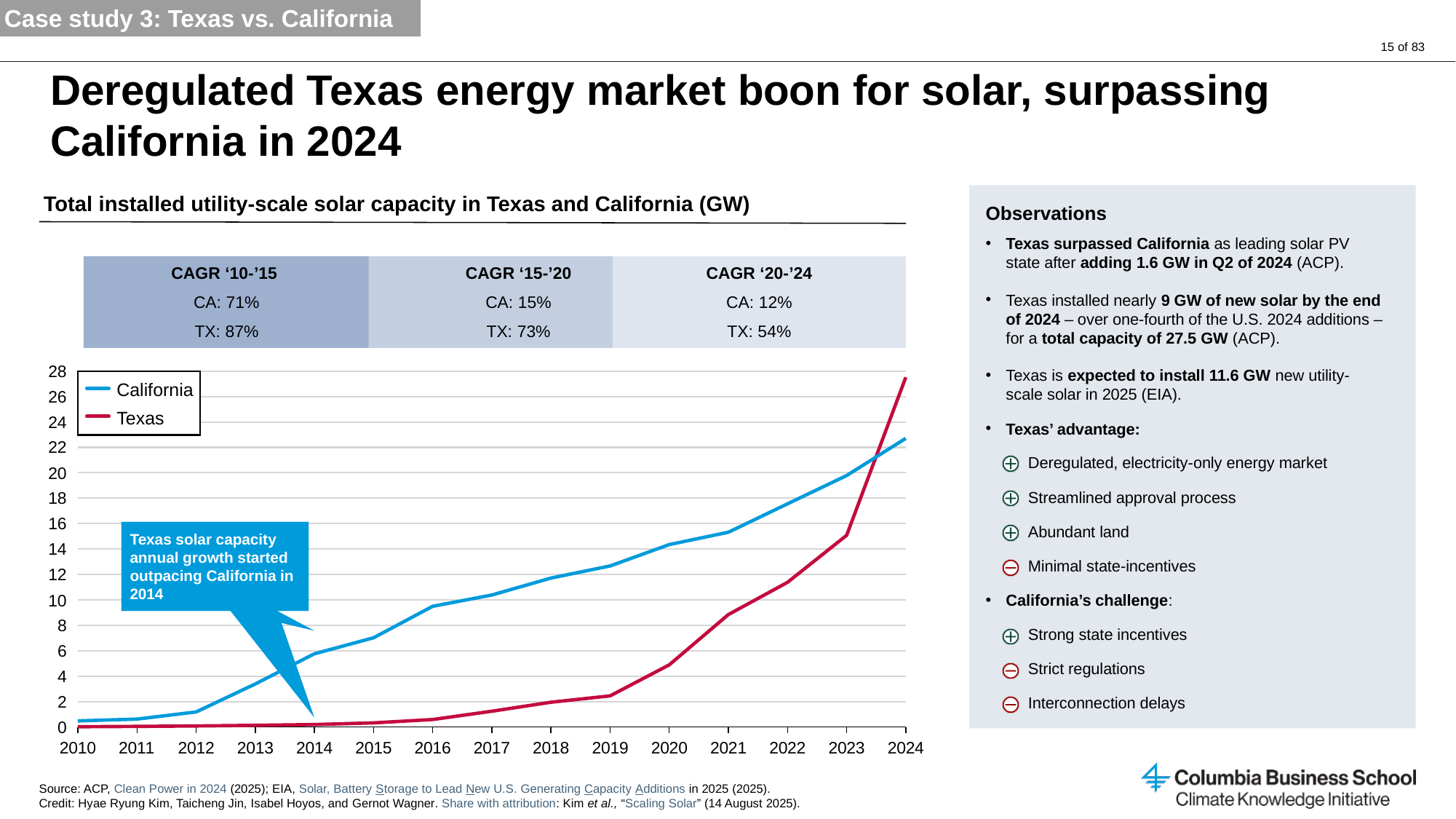
Is the value for Texas in 2022 greater or less than 10? greater Which two series are listed in the chart legend? California and Texas How many years are shown along the x axis of the chart? 15 Does California's installed solar capacity rise or fall from 2010 to 2024? rise In 2020, which state has the higher installed solar capacity, Texas or California? California What is the title of the chart? Total installed utility-scale solar capacity in Texas and California (GW) What kind of chart is shown on the slide? line chart Is the value for California in 2024 greater or less than 20? greater In 2024, which state has the higher installed solar capacity, Texas or California? Texas Is the value for Texas in 2024 greater or less than 26? greater How many series does the chart legend list? 2 What is the CAGR for Texas over 2015-2020 shown above the chart? 73%